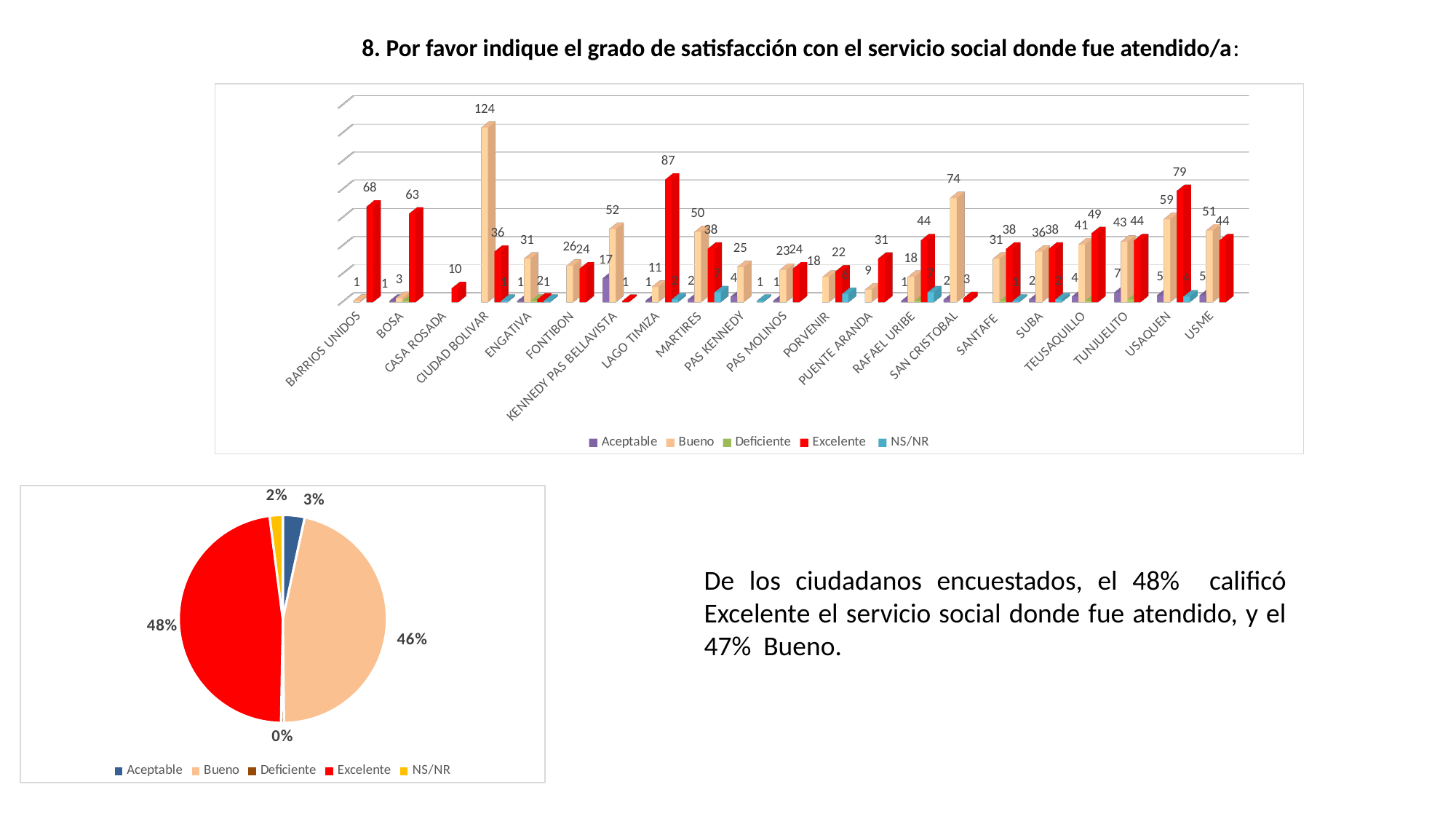
How many series does the legend of the top bar chart list? 5 In the top bar chart, what is the Bueno value for CIUDAD BOLIVAR? 124 In the top bar chart, what is the difference between the Excelente value for USAQUEN and the Bueno value for USAQUEN? 20 In the top bar chart, which is larger for MARTIRES: the Bueno value or the Excelente value? Bueno In the top bar chart, which category has the highest Excelente value? LAGO TIMIZA In the top bar chart, which category has the highest Bueno value? CIUDAD BOLIVAR What kind of chart is the chart at the bottom left of the slide? Pie chart In the top bar chart, what is the Bueno value for SAN CRISTOBAL? 74 In the pie chart at the bottom left, what share does Excelente have? 48% In the pie chart at the bottom left, what share does Bueno have? 46% How many categories are shown on the x axis of the top bar chart? 21 In the top bar chart, what is the Excelente value for LAGO TIMIZA? 87